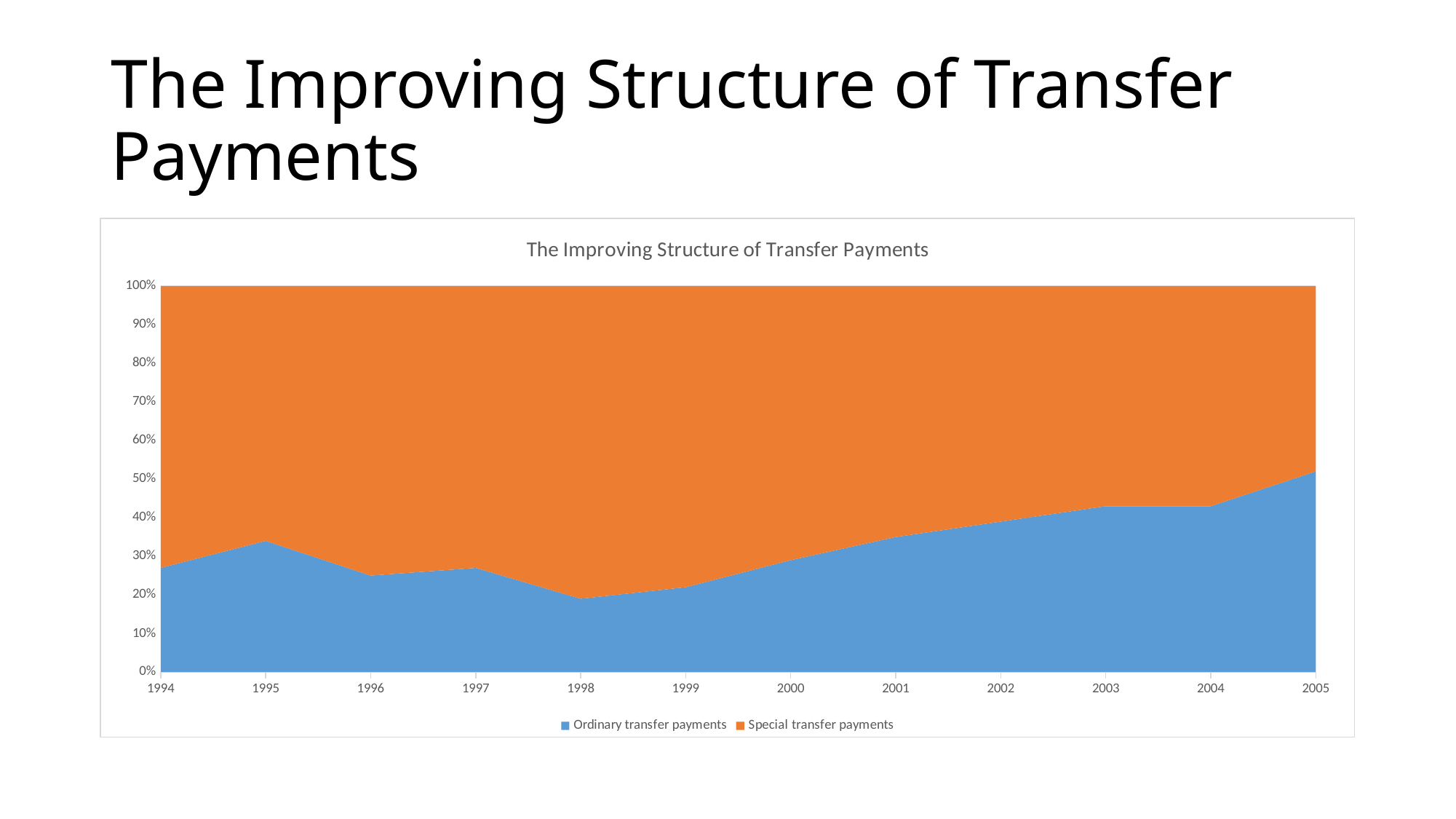
What kind of chart is shown on the slide? Stacked area chart In which year is the share of Ordinary transfer payments lowest? 1998 Which series is shown in orange? Special transfer payments Is the share of Ordinary transfer payments in 1998 greater or less than 30%? less What is the title of the chart? The Improving Structure of Transfer Payments Is the share of Ordinary transfer payments in 2003 greater or less than 40%? greater How many years are shown along the x axis? 12 How many series does the legend list? 2 Is the share of Ordinary transfer payments in 2005 greater or less than 50%? greater In which year is the share of Ordinary transfer payments highest? 2005 Which year has a larger share of Ordinary transfer payments, 1995 or 1996? 1995 Does the share of Ordinary transfer payments rise or fall from 1998 to 2005? rise